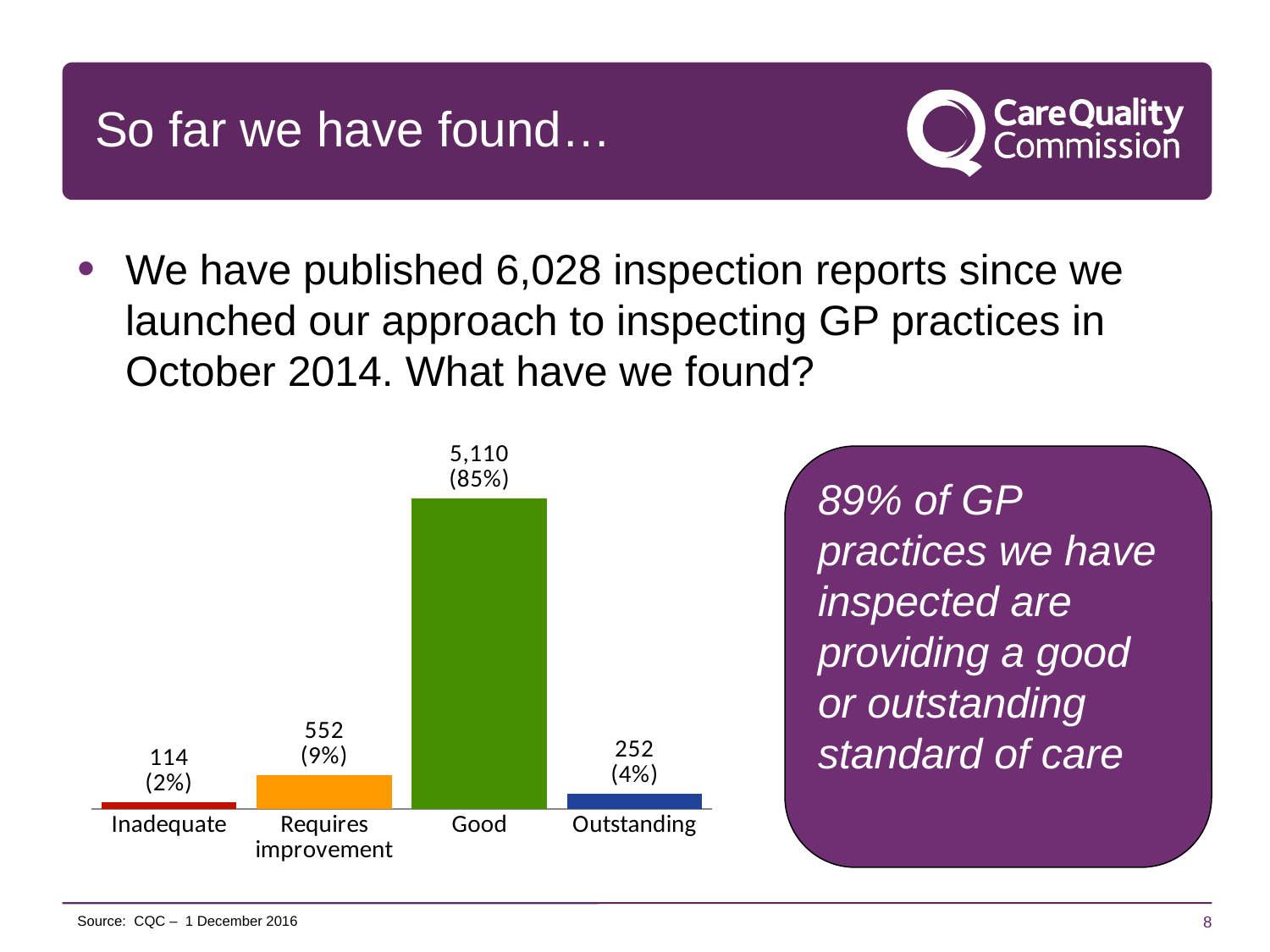
What kind of chart is shown on the slide? Bar chart Which category has the highest value? Good How many categories are shown on the chart? 4 What is the difference between the counts for Requires improvement and Outstanding? 300 Which category has the lowest value? Inadequate What is the value for Inadequate? 114 (2%) Which is larger, the value for Outstanding or the value for Inadequate? Outstanding What is the difference between the counts for Good and Inadequate? 4,996 What is the value for Requires improvement? 552 (9%) What colour is the bar for Good? Green What is the value for Good? 5,110 (85%) What is the value for Outstanding? 252 (4%)